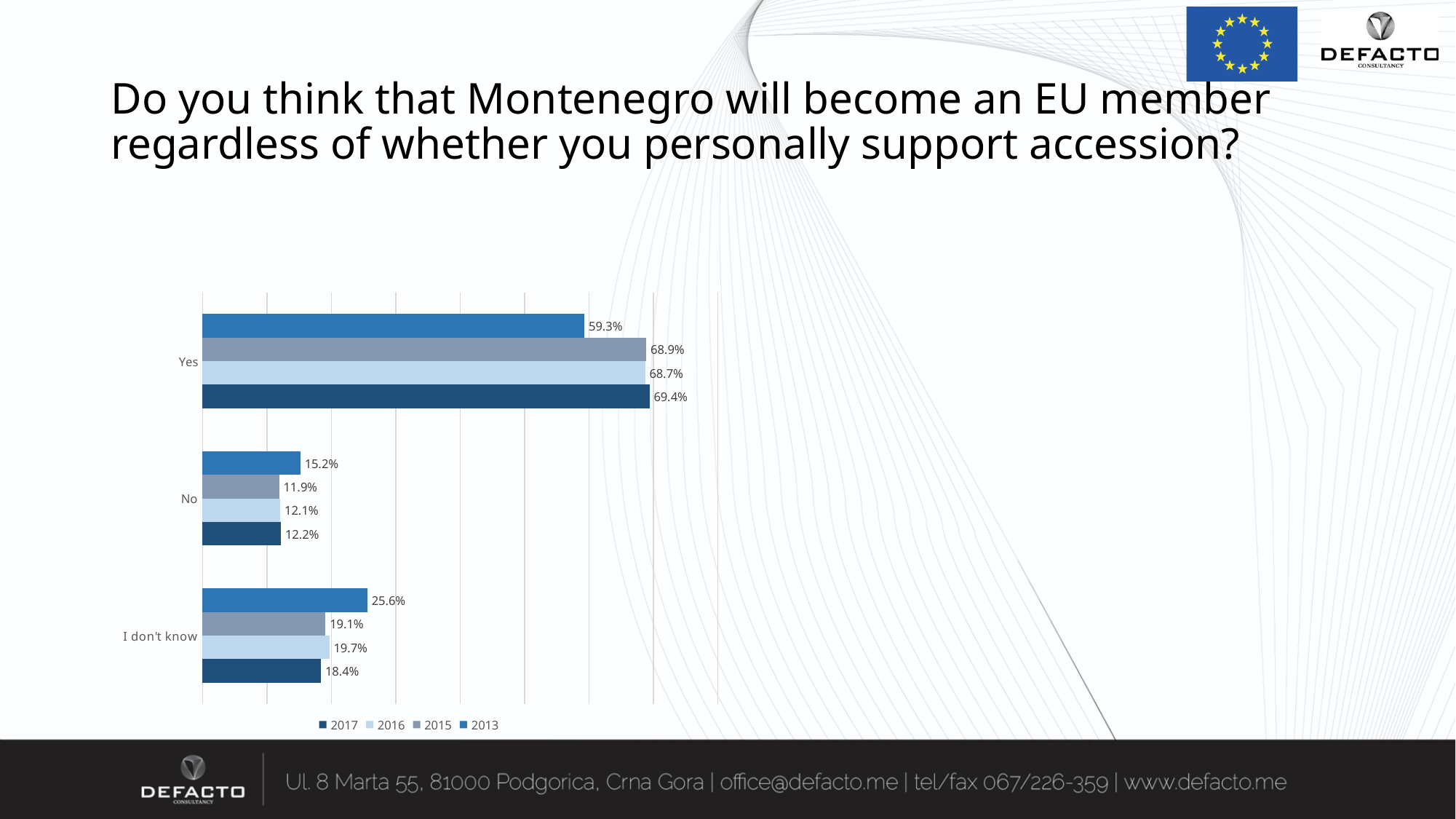
In which year was the share of "I don't know" answers the highest? 2013 What type of chart is shown on the slide? Bar chart In which year was the share of "Yes" answers the lowest? 2013 Which years are listed in the chart legend? 2017, 2016, 2015, 2013 What percentage of respondents answered "No" in 2013? 15.2% How many series does the legend list? 4 What is the difference between the "Yes" share in 2017 and in 2013? 10.1 percentage points How many answer categories are shown on the chart? 3 What percentage of respondents answered "Yes" in 2017? 69.4% What percentage of respondents answered "Yes" in 2015? 68.9% Which is larger: the "No" share in 2013 or the "No" share in 2017? 2013 What percentage of respondents answered "I don't know" in 2016? 19.7%